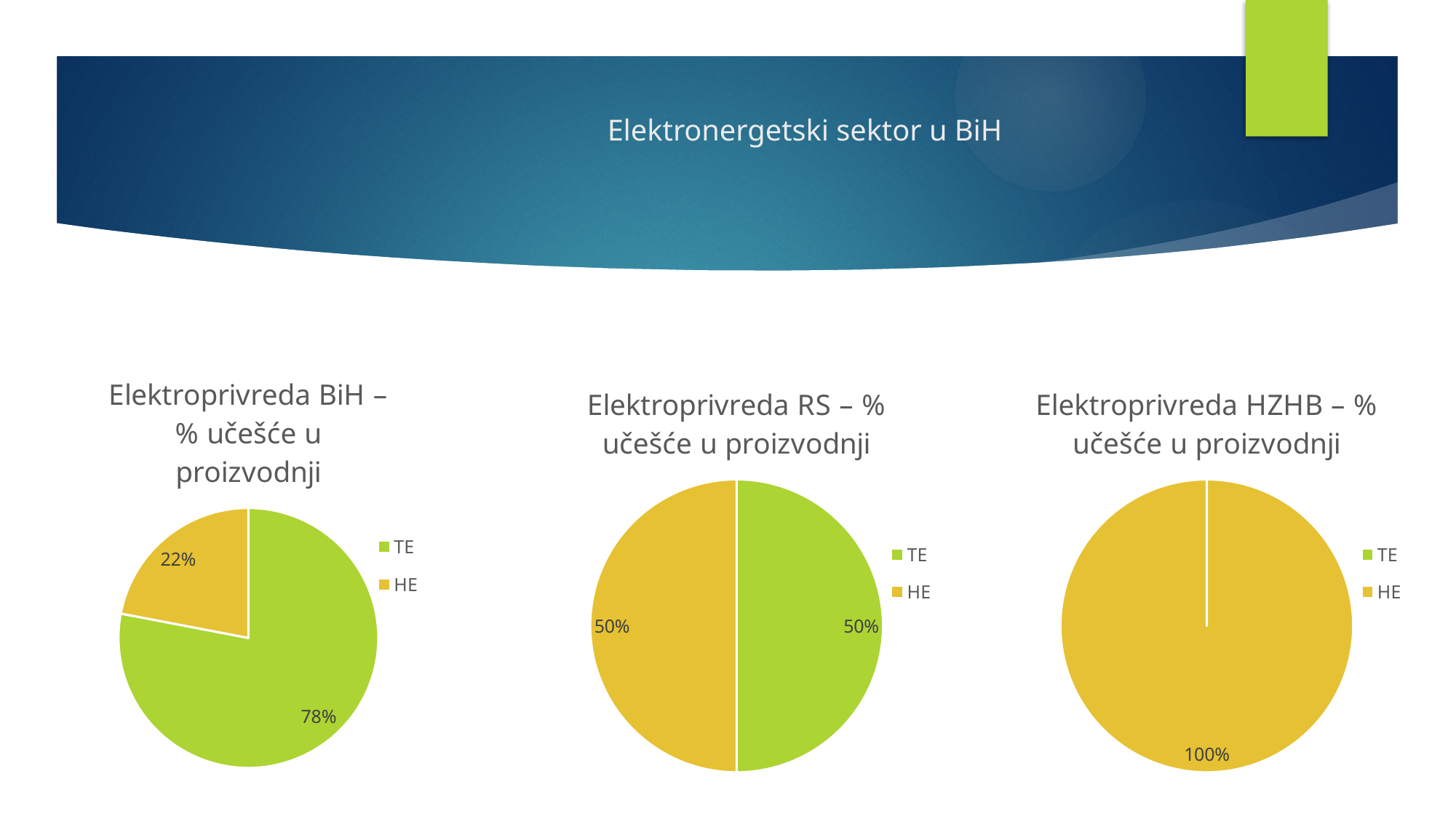
In the 'Elektroprivreda BiH – % učešće u proizvodnji' chart, what is the share for TE? 78% In the 'Elektroprivreda BiH – % učešće u proizvodnji' chart, which category has the largest slice? TE In the 'Elektroprivreda RS – % učešće u proizvodnji' chart, what is the share for HE? 50% In the 'Elektroprivreda BiH – % učešće u proizvodnji' chart, what is the share for HE? 22% How many charts are shown on the slide? 3 In the 'Elektroprivreda HZHB – % učešće u proizvodnji' chart, what is the share for HE? 100% In the 'Elektroprivreda HZHB – % učešće u proizvodnji' chart, which category makes up the whole pie? HE In the 'Elektroprivreda RS – % učešće u proizvodnji' chart, what is the share for TE? 50% In the 'Elektroprivreda BiH – % učešće u proizvodnji' chart, what is the difference between the TE and HE shares? 56% What kind of chart is the 'Elektroprivreda RS – % učešće u proizvodnji' chart? Pie chart In the 'Elektroprivreda BiH – % učešće u proizvodnji' chart, which colour represents HE? Yellow How many entries does the legend of the 'Elektroprivreda BiH – % učešće u proizvodnji' chart list? 2